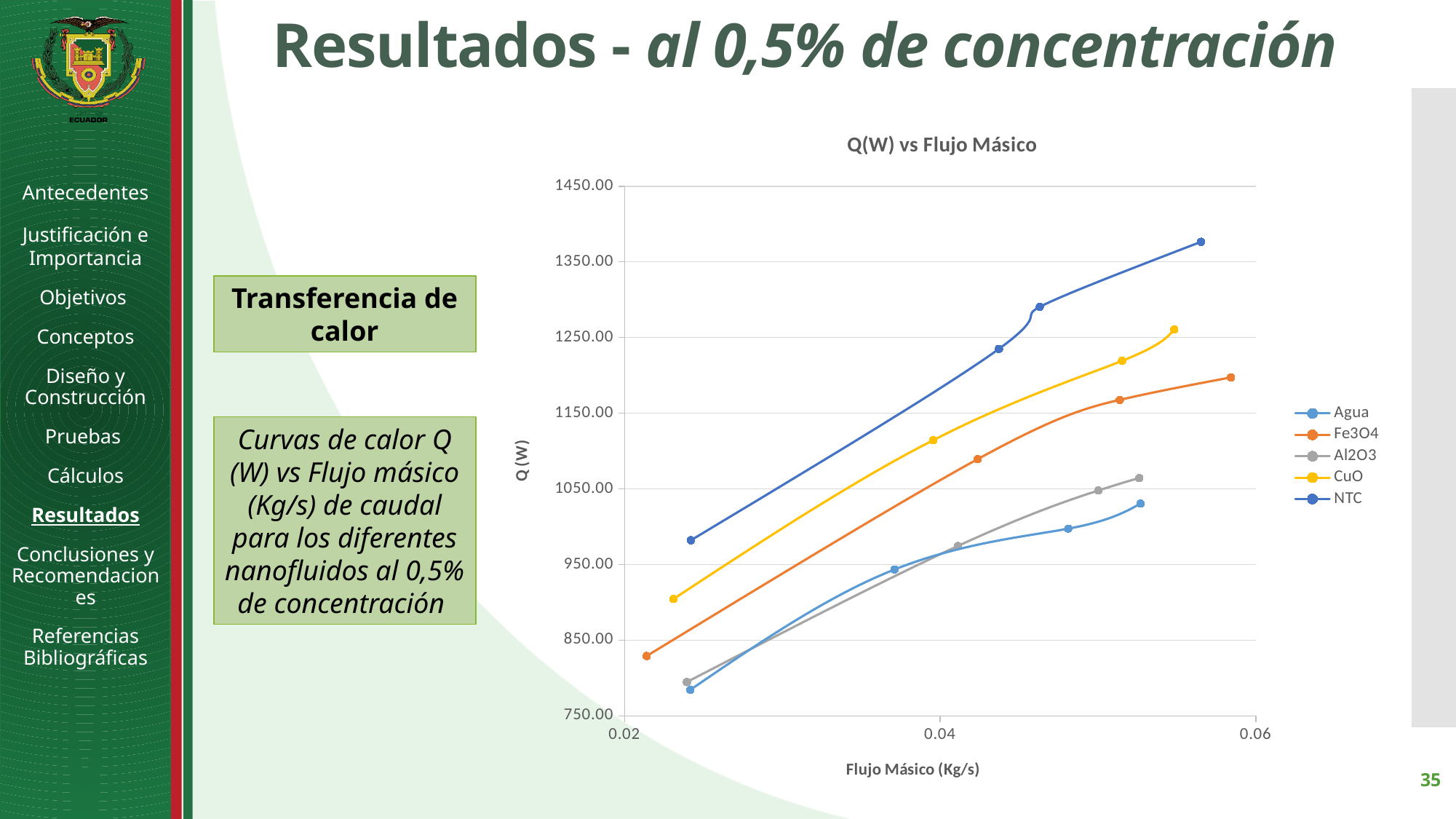
What is the label of the x axis of the chart? Flujo Másico (Kg/s) At their highest mass flow points, which series has the larger Q (W) value, NTC or CuO? NTC Which series has the lowest Q (W) values on the chart? Agua Is the first (lowest flow) Q (W) value of the Agua series greater or less than 850? less What kind of chart is shown on the slide? line chart How many data points are plotted for the NTC series? 4 Is the first (lowest flow) Q (W) value of the Fe3O4 series greater or less than 850? less Which series reaches the highest Q (W) value on the chart? NTC What is the title of the chart? Q(W) vs Flujo Másico Do the Q (W) values for the NTC series rise or fall as the mass flow increases? rise How many series does the legend of the chart list? 5 Is the highest Q (W) value of the NTC series greater or less than 1350? greater